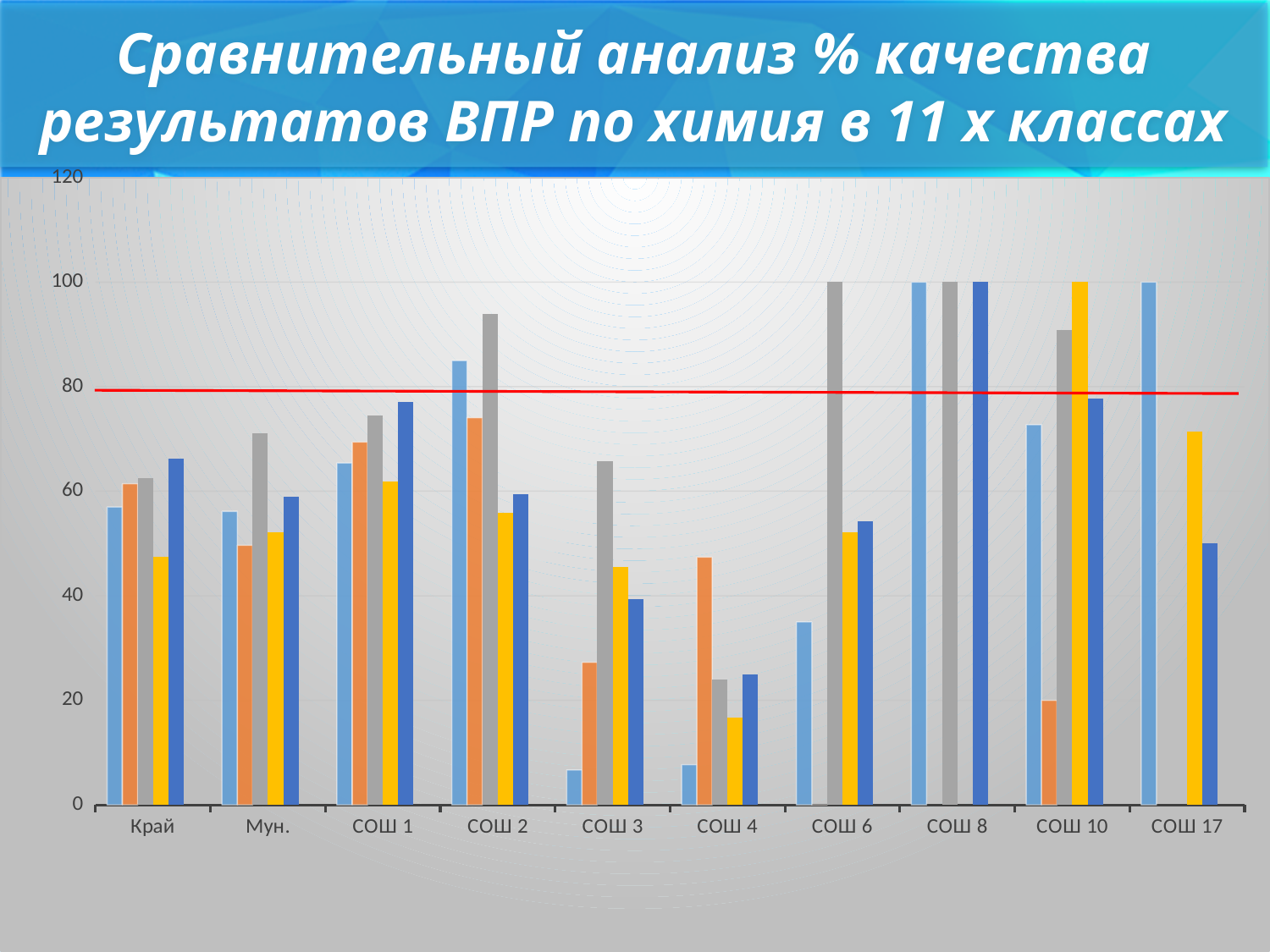
Is the value of the orange bar for СОШ 4 greater or less than 60? less What is the value of the gray bar for СОШ 6? 100 What is the value of the yellow bar for СОШ 10? 100 How many differently coloured bars are plotted for the category Край? 5 Which is larger for СОШ 3: the gray bar or the orange bar? the gray bar Is the value of the gray bar for СОШ 2 greater or less than 80? greater What is the title of the chart on the slide? Сравнительный анализ % качества результатов ВПР по химия в 11 х классах What is the value of the light blue bar for СОШ 17? 100 What kind of chart is shown on the slide? bar chart Is the value of the light blue bar for СОШ 3 greater or less than 20? less How many categories are shown along the x axis of the chart? 10 Which category has the lowest light blue bar? СОШ 3